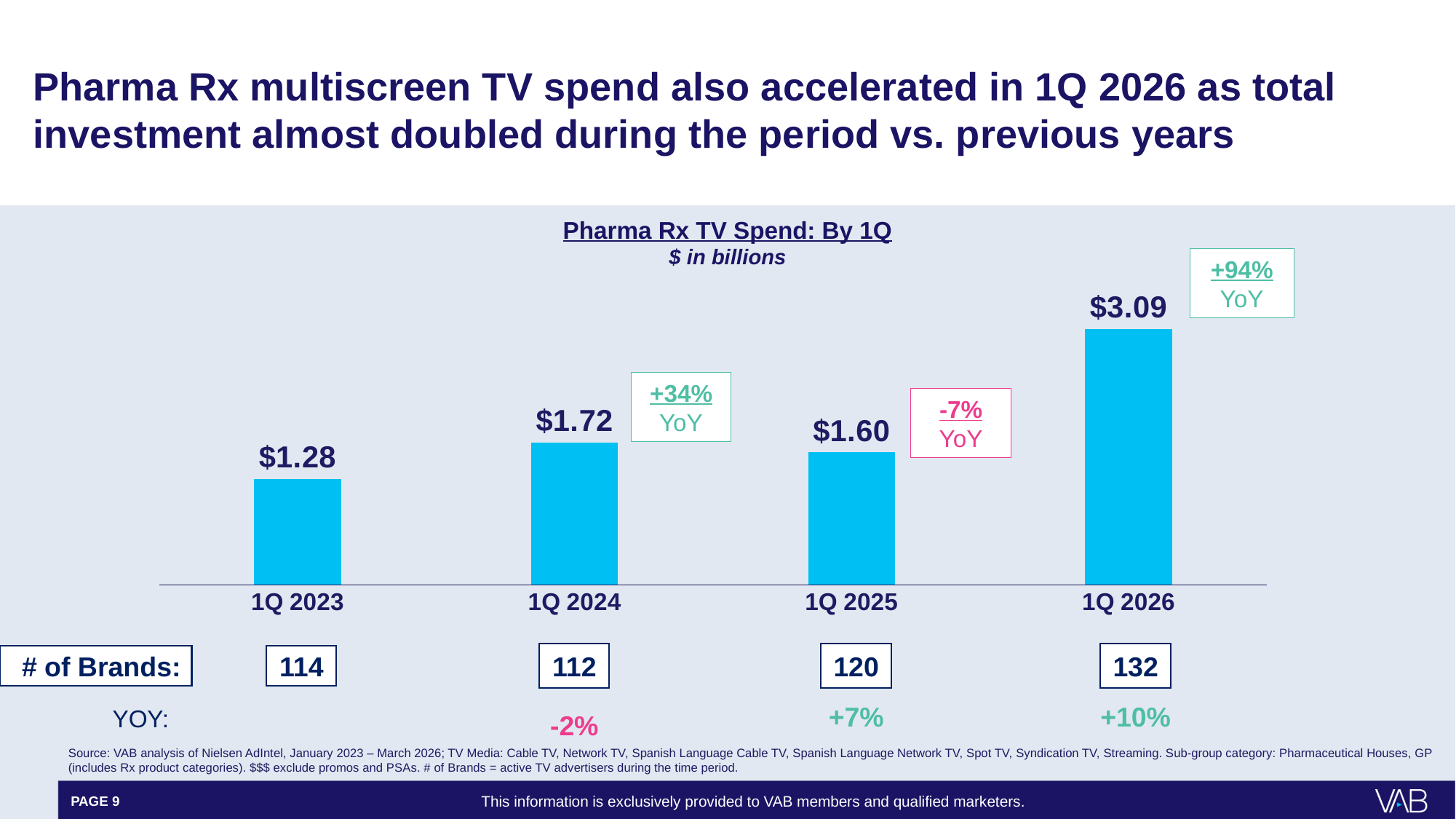
What unit is the Pharma Rx TV Spend chart measured in, according to its subtitle? $ in billions What is the year-over-year change in Pharma Rx TV spend shown for 1Q 2026? +94% What is the Pharma Rx TV spend for 1Q 2023? $1.28 What kind of chart is the Pharma Rx TV Spend: By 1Q chart? Bar chart What is the difference in Pharma Rx TV spend between 1Q 2024 and 1Q 2023? $0.44 How many quarters are shown in the Pharma Rx TV Spend chart? 4 Which is larger, the Pharma Rx TV spend in 1Q 2024 or in 1Q 2025? 1Q 2024 Which quarter has the lowest Pharma Rx TV spend? 1Q 2023 Which quarter has the highest Pharma Rx TV spend? 1Q 2026 What is the Pharma Rx TV spend for 1Q 2026? $3.09 What is the Pharma Rx TV spend for 1Q 2025? $1.60 What is the difference in Pharma Rx TV spend between 1Q 2026 and 1Q 2025? $1.49